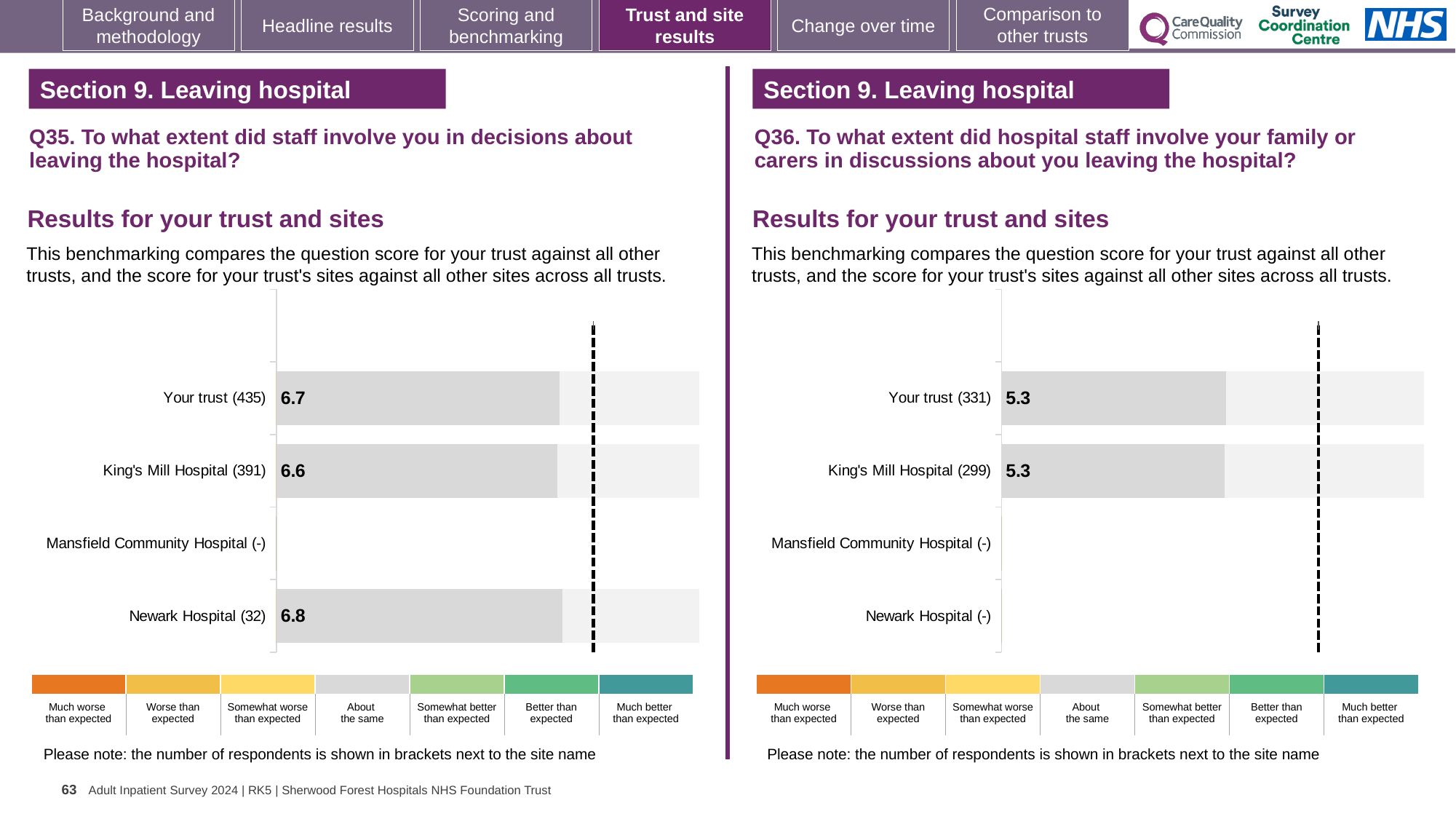
In the Q35 chart on the left, is the score for Your trust larger or smaller than the score for King's Mill Hospital? Larger In the Q36 chart on the right, what is the score for King's Mill Hospital? 5.3 In the Q36 chart on the right, how many respondents are shown in brackets for Your trust? 331 In the Q36 chart on the right, what is the score for Your trust? 5.3 In the Q35 chart on the left, how many respondents are shown in brackets for Newark Hospital? 32 In the Q35 chart on the left, what is the difference between the Newark Hospital score and the King's Mill Hospital score? 0.2 In the Q35 chart on the left, which site has the highest score? Newark Hospital In the Q35 chart on the left, what is the score for King's Mill Hospital? 6.6 What kind of chart is used in the Q35 chart on the left? Bar chart In the Q36 chart on the right, how many sites (excluding Your trust) have a score bar plotted? 1 In the Q35 chart on the left, what is the score for Your trust? 6.7 In the Q35 chart on the left, what is the score for Newark Hospital? 6.8